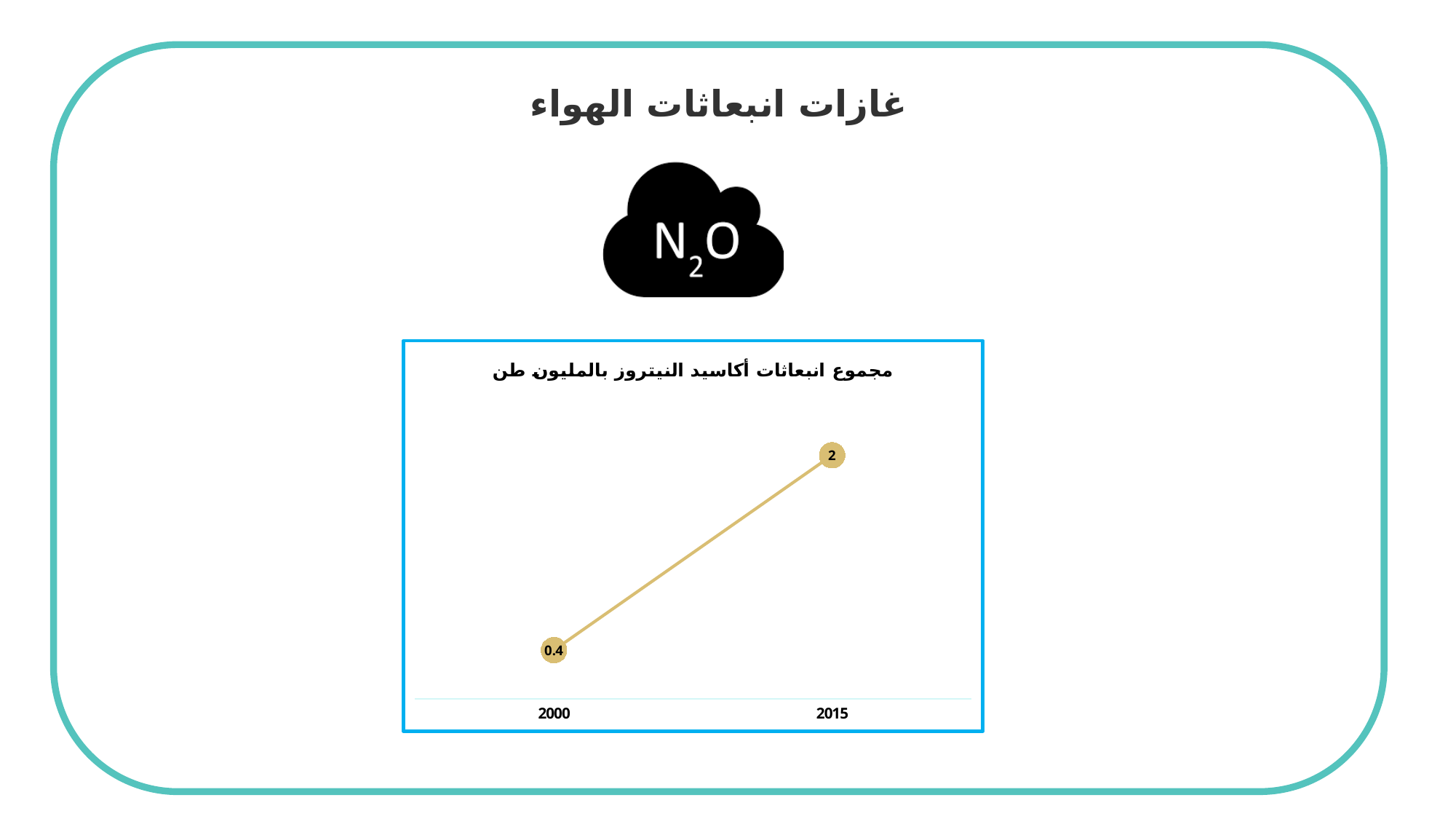
Do the values rise or fall from 2000 to 2015? rise What kind of chart is shown on the slide? line chart What is the value for 2000? 0.4 What is the title of the chart? مجموع انبعاثات أكاسيد النيتروز بالمليون طن How many data points are plotted on the chart? 2 Which is larger, the value for 2000 or the value for 2015? 2015 What is the value for 2015? 2 Which year has the highest value? 2015 What is the difference between the values for 2015 and 2000? 1.6 What is the title of the slide? غازات انبعاثات الهواء Which year has the lowest value? 2000